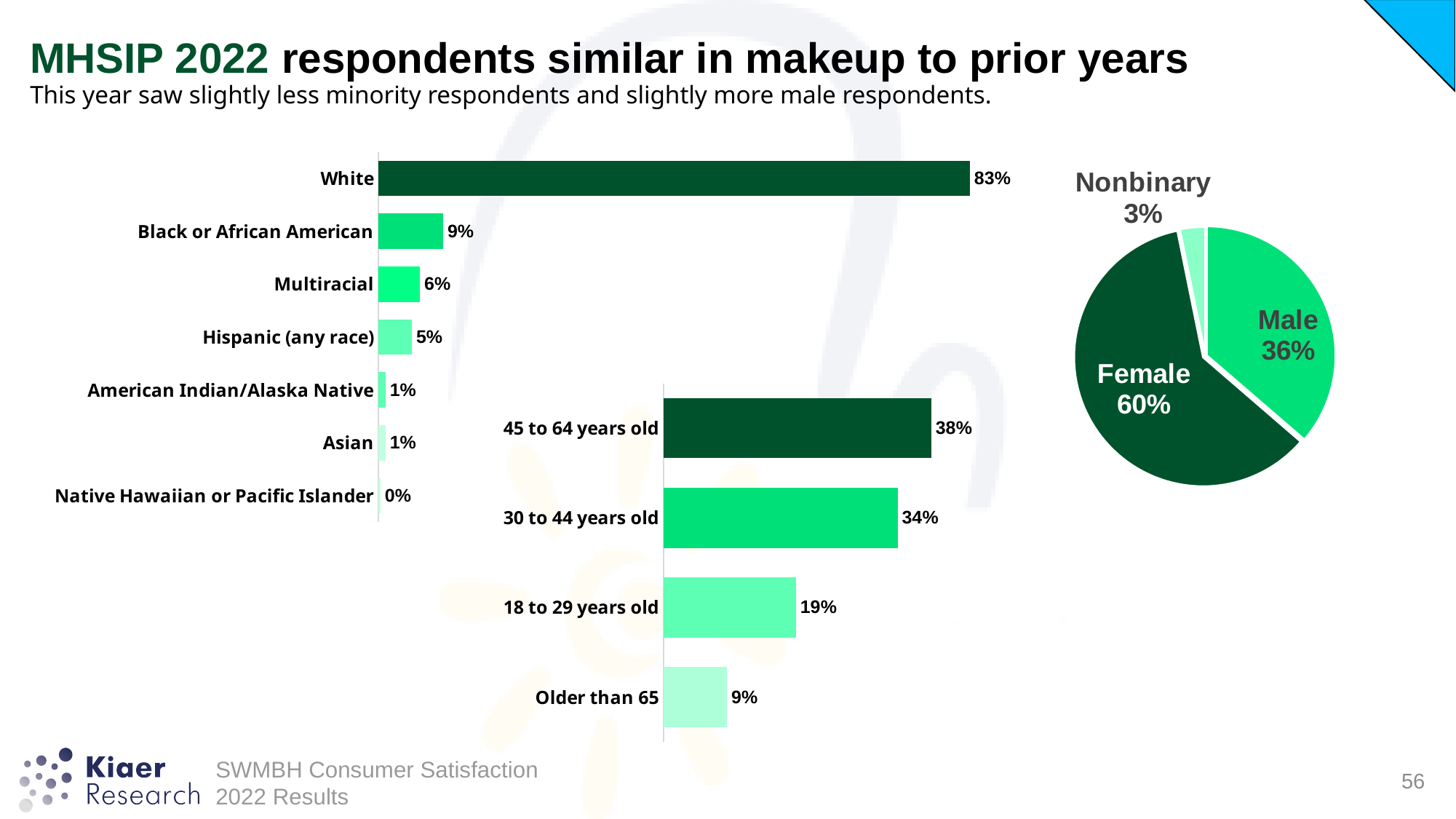
In the race/ethnicity bar chart on the left, which category has the highest value? White In the age bar chart in the middle, which age group has the highest value? 45 to 64 years old In the race/ethnicity bar chart on the left, what percentage of respondents are White? 83% In the race/ethnicity bar chart on the left, how many categories are shown? 7 In the age bar chart in the middle, what is the difference between 45 to 64 years old and 18 to 29 years old? 19% What type of chart is used to show the gender breakdown on the right? Pie chart In the gender pie chart on the right, what share of respondents are Female? 60% In the age bar chart in the middle, which is larger: 18 to 29 years old or Older than 65? 18 to 29 years old In the race/ethnicity bar chart on the left, which category has the lowest value? Native Hawaiian or Pacific Islander In the age bar chart in the middle, what is the value for 30 to 44 years old? 34% In the race/ethnicity bar chart on the left, what is the difference between the Multiracial and Hispanic (any race) values? 1% In the race/ethnicity bar chart on the left, what is the value for Black or African American? 9%